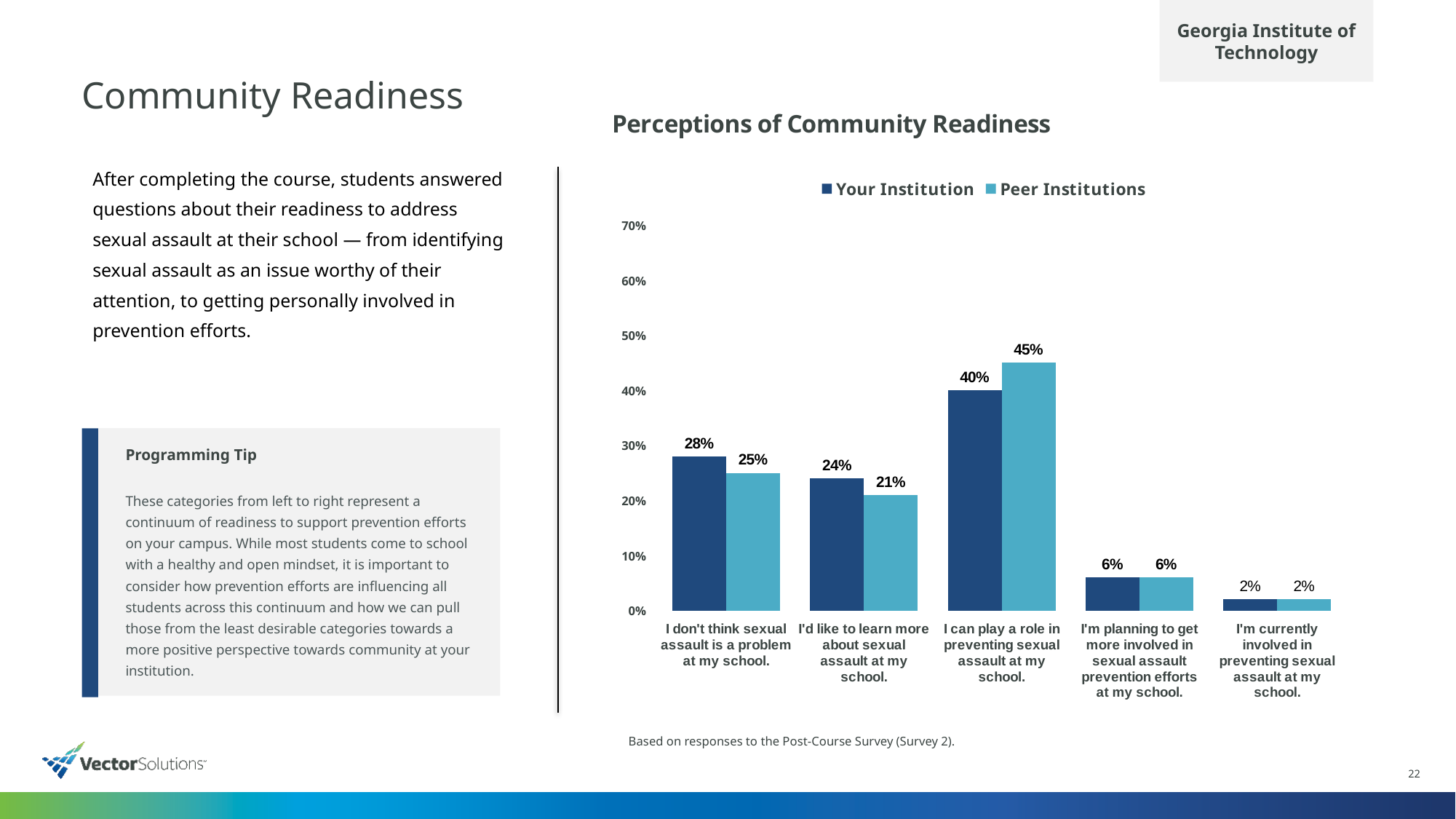
What is the value for Peer Institutions for "I'm planning to get more involved in sexual assault prevention efforts at my school."? 6% What is the value for Your Institution for "I can play a role in preventing sexual assault at my school."? 40% What is the value for Peer Institutions for "I don't think sexual assault is a problem at my school."? 25% What is the title of the chart? Perceptions of Community Readiness What is the value for Your Institution for "I'd like to learn more about sexual assault at my school."? 24% How many categories are shown on the x axis? 5 Which is larger for "I'd like to learn more about sexual assault at my school.": Your Institution or Peer Institutions? Your Institution How many series does the legend list? 2 What kind of chart is shown? Bar chart What is the difference between Peer Institutions and Your Institution for "I can play a role in preventing sexual assault at my school."? 5% Which category has the highest value for Peer Institutions? I can play a role in preventing sexual assault at my school. Which category has the lowest value for Your Institution? I'm currently involved in preventing sexual assault at my school.